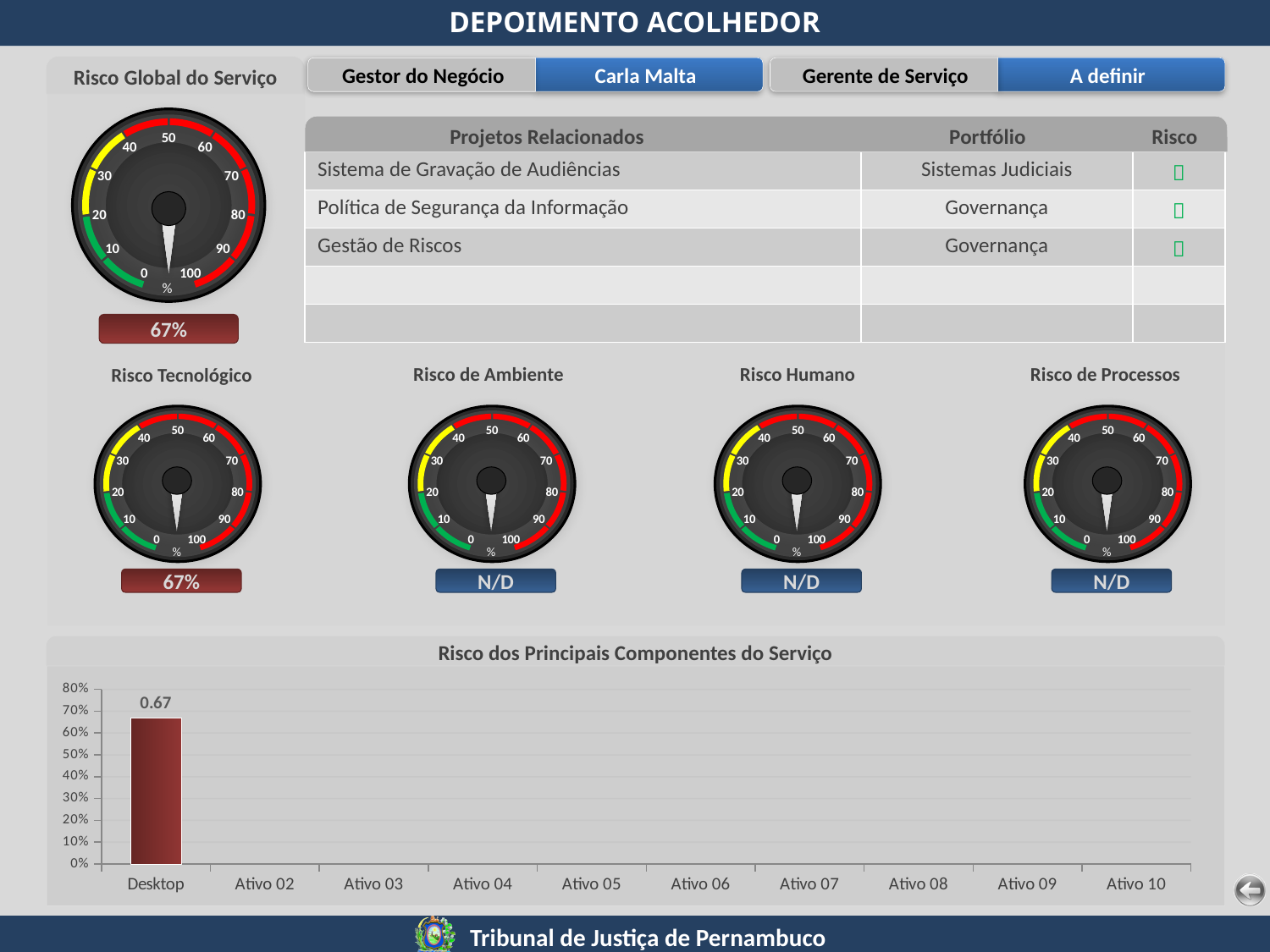
What value is shown below the 'Risco Global do Serviço' gauge? 67% In the chart 'Risco dos Principais Componentes do Serviço', which category has the highest value? Desktop In the chart 'Risco dos Principais Componentes do Serviço', is the value for Desktop greater or less than 70%? less What is the highest value shown on the y axis of the chart 'Risco dos Principais Componentes do Serviço'? 80% What value is shown below the 'Risco de Processos' gauge? N/D What is the title of the bar chart at the bottom of the slide? Risco dos Principais Componentes do Serviço What kind of chart is 'Risco dos Principais Componentes do Serviço'? bar chart In the chart 'Risco dos Principais Componentes do Serviço', is the value for Desktop greater or less than 60%? greater In the chart 'Risco dos Principais Componentes do Serviço', what is the data label shown on the Desktop bar? 0.67 What value is shown below the 'Risco Humano' gauge? N/D How many categories are listed on the x axis of the chart 'Risco dos Principais Componentes do Serviço'? 10 What value is shown below the 'Risco Tecnológico' gauge? 67%